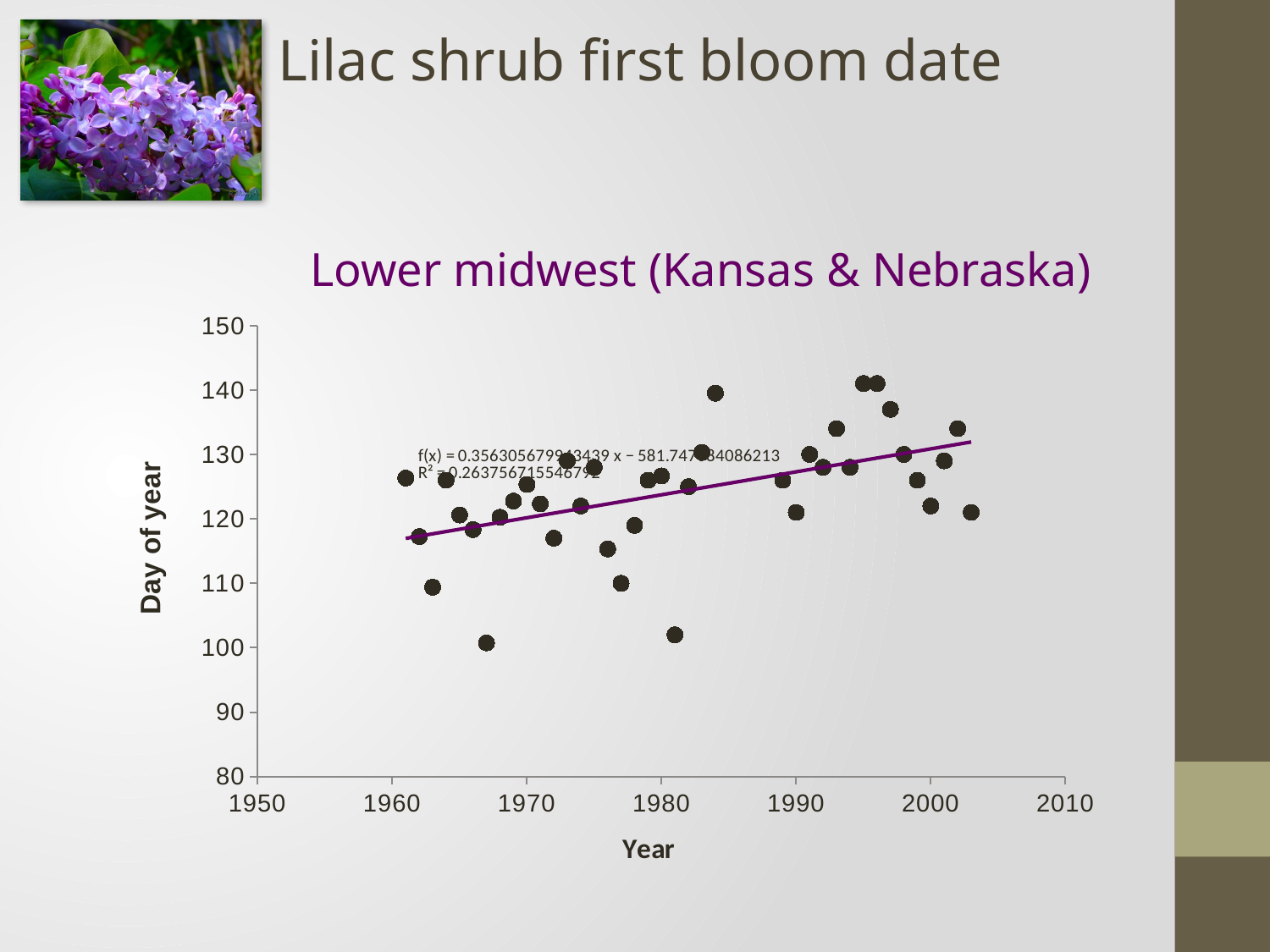
What is the title of the chart? Lower midwest (Kansas & Nebraska) Is the value for 1993 greater or less than 130? greater Does the trend line show the first bloom day of year rising or falling over the years? rising Is the value for 1982 greater or less than 110? greater Is the value for 1967 greater or less than 110? less What kind of chart is shown on the slide? scatter plot What is the label of the vertical axis? Day of year Which year has the larger value, 1967 or 1984? 1984